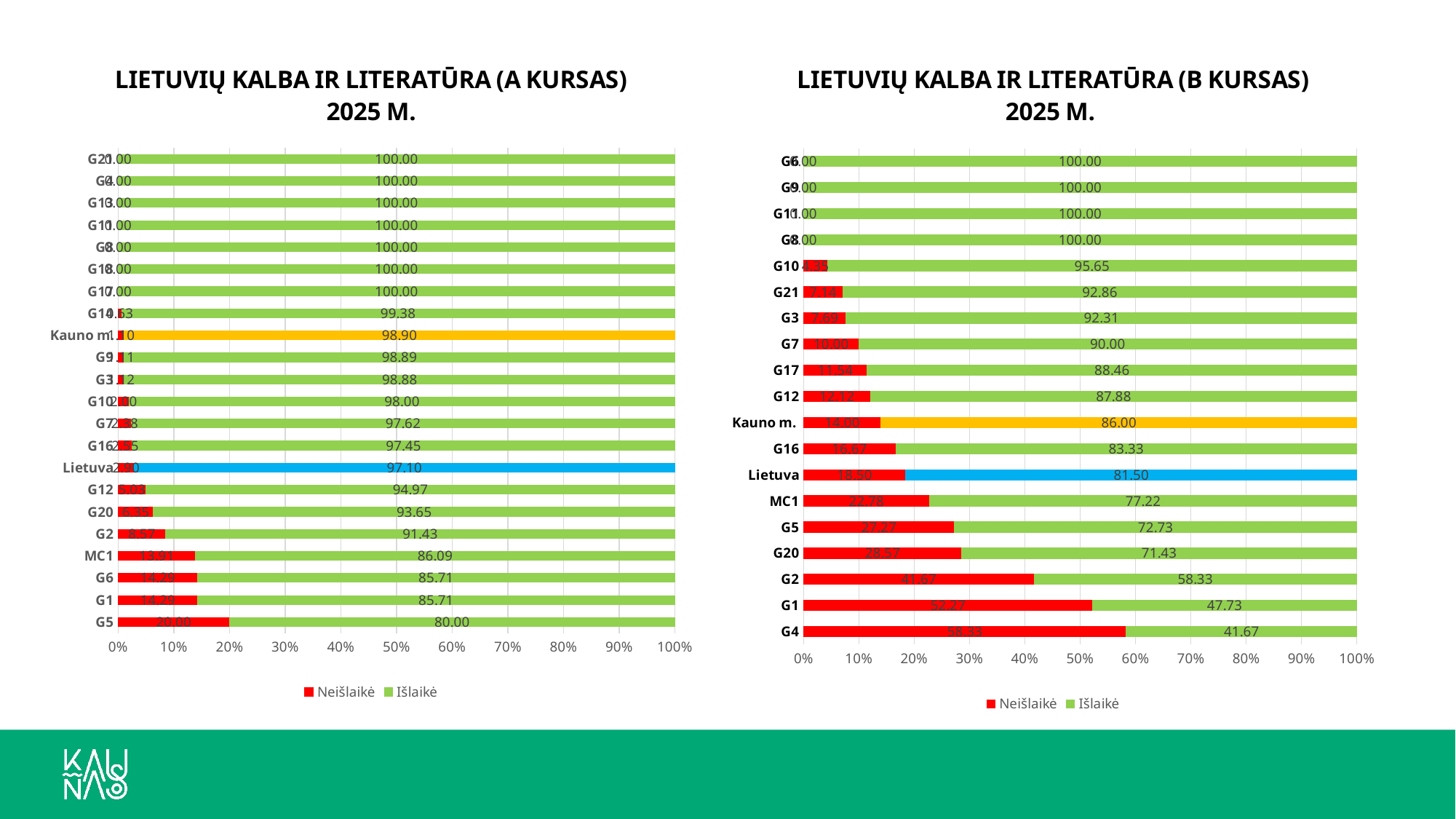
In the A kursas chart, which is larger, the Neišlaikė value for G2 or for G20? G2 How many series does the legend of the A kursas chart list? 2 In the B kursas chart, is the Neišlaikė value for G1 greater or less than 50%? greater In the A kursas chart, which category has the lowest Išlaikė value? G5 What type of chart is the B kursas chart? Stacked bar chart In the A kursas chart, what is the Neišlaikė value for MC1? 13.91 In the B kursas chart, what is the Išlaikė value for Lietuva? 81.50 In the A kursas chart, what is the Išlaikė value for G5? 80.00 How many categories are shown in the B kursas chart? 19 In the B kursas chart, what is the Neišlaikė value for Kauno m.? 14.00 In the B kursas chart, what is the difference between the Išlaikė values of G2 and G4? 16.66 In the B kursas chart, which category has the highest Neišlaikė value? G4